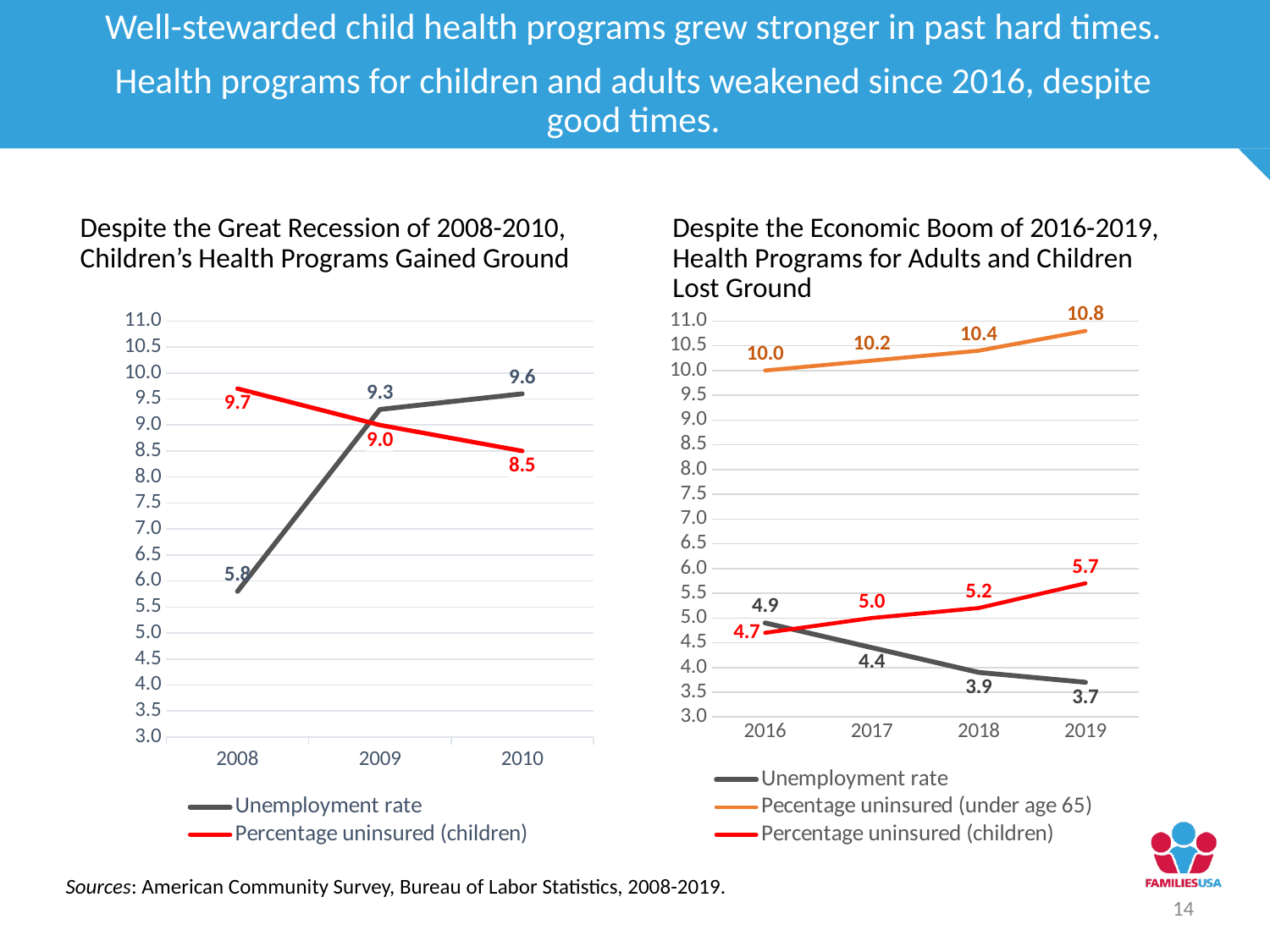
In the left chart (Despite the Great Recession of 2008-2010), how many series does the legend list? 2 In the left chart (Despite the Great Recession of 2008-2010), what is the difference between the unemployment rate in 2009 and in 2008? 3.5 In the right chart (Despite the Economic Boom of 2016-2019), what is the percentage uninsured (under age 65) in 2019? 10.8 In the right chart (Despite the Economic Boom of 2016-2019), how many years are plotted on the x axis? 4 In the left chart (Despite the Great Recession of 2008-2010), what is the percentage uninsured (children) in 2008? 9.7 In the left chart (Despite the Great Recession of 2008-2010), in which year is the unemployment rate lowest? 2008 What kind of chart is the right chart (Despite the Economic Boom of 2016-2019)? Line chart In the right chart (Despite the Economic Boom of 2016-2019), what is the difference between the percentage uninsured (children) in 2019 and in 2016? 1.0 In the right chart (Despite the Economic Boom of 2016-2019), which is larger in 2016: the unemployment rate or the percentage uninsured (children)? Unemployment rate In the left chart (Despite the Great Recession of 2008-2010), does the percentage uninsured (children) rise or fall from 2008 to 2010? fall In the left chart (Despite the Great Recession of 2008-2010), what is the unemployment rate in 2010? 9.6 In the right chart (Despite the Economic Boom of 2016-2019), what is the unemployment rate in 2018? 3.9